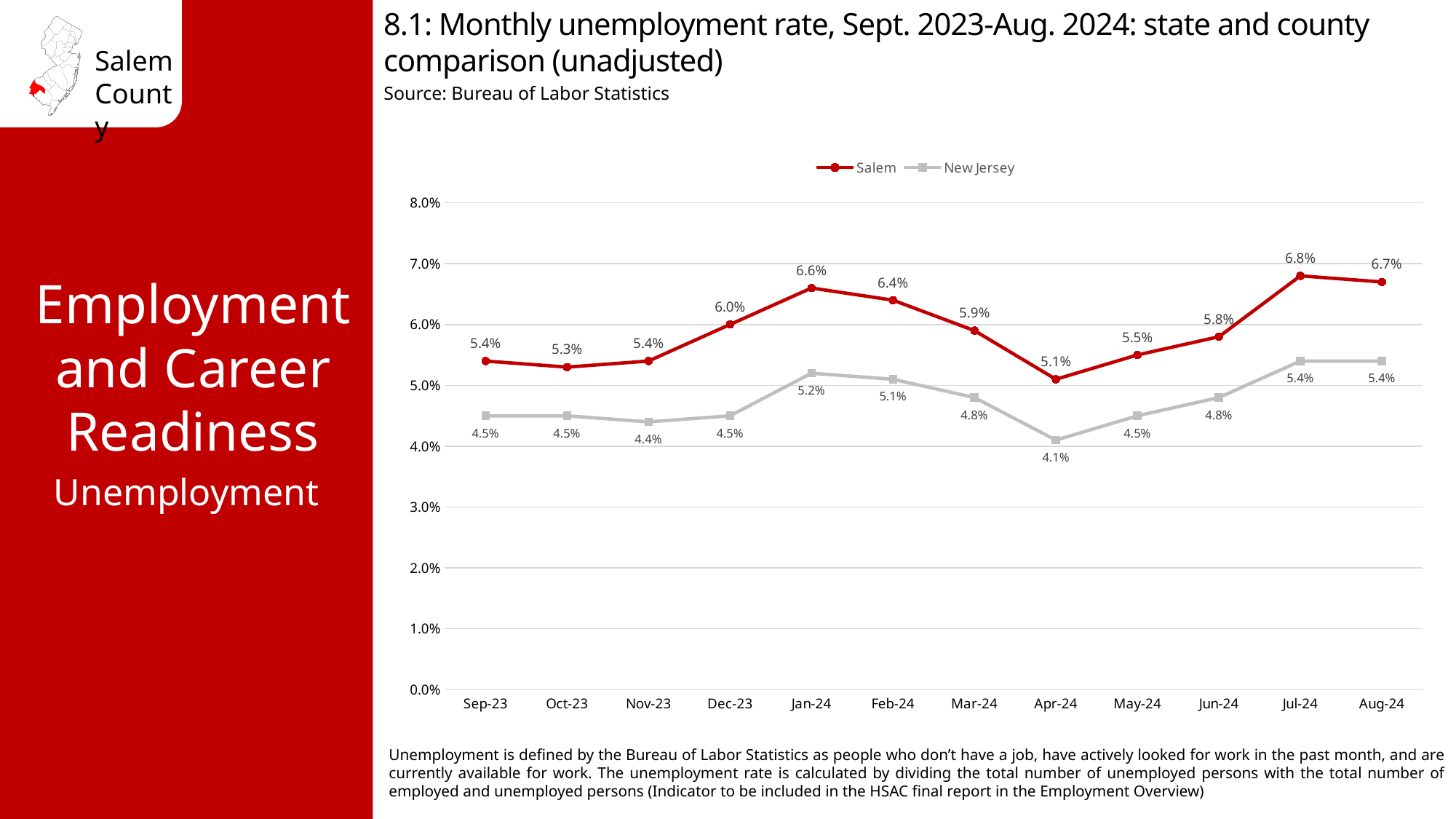
In which month did New Jersey have its lowest unemployment rate? Apr-24 What kind of chart is shown on the slide? Line chart What is the source cited for the chart? Bureau of Labor Statistics What is the difference between the Salem and New Jersey unemployment rates in Aug-24? 1.3% What was the Salem unemployment rate in Jan-24? 6.6% Is the Salem unemployment rate in Jul-24 greater or less than 6.0%? greater Did the Salem unemployment rate rise or fall from Apr-24 to Jul-24? Rise How many series does the legend list? 2 Which series had the higher unemployment rate in Mar-24, Salem or New Jersey? Salem How many months are plotted on the x axis? 12 What was the New Jersey unemployment rate in Apr-24? 4.1% In which month did Salem have its highest unemployment rate? Jul-24